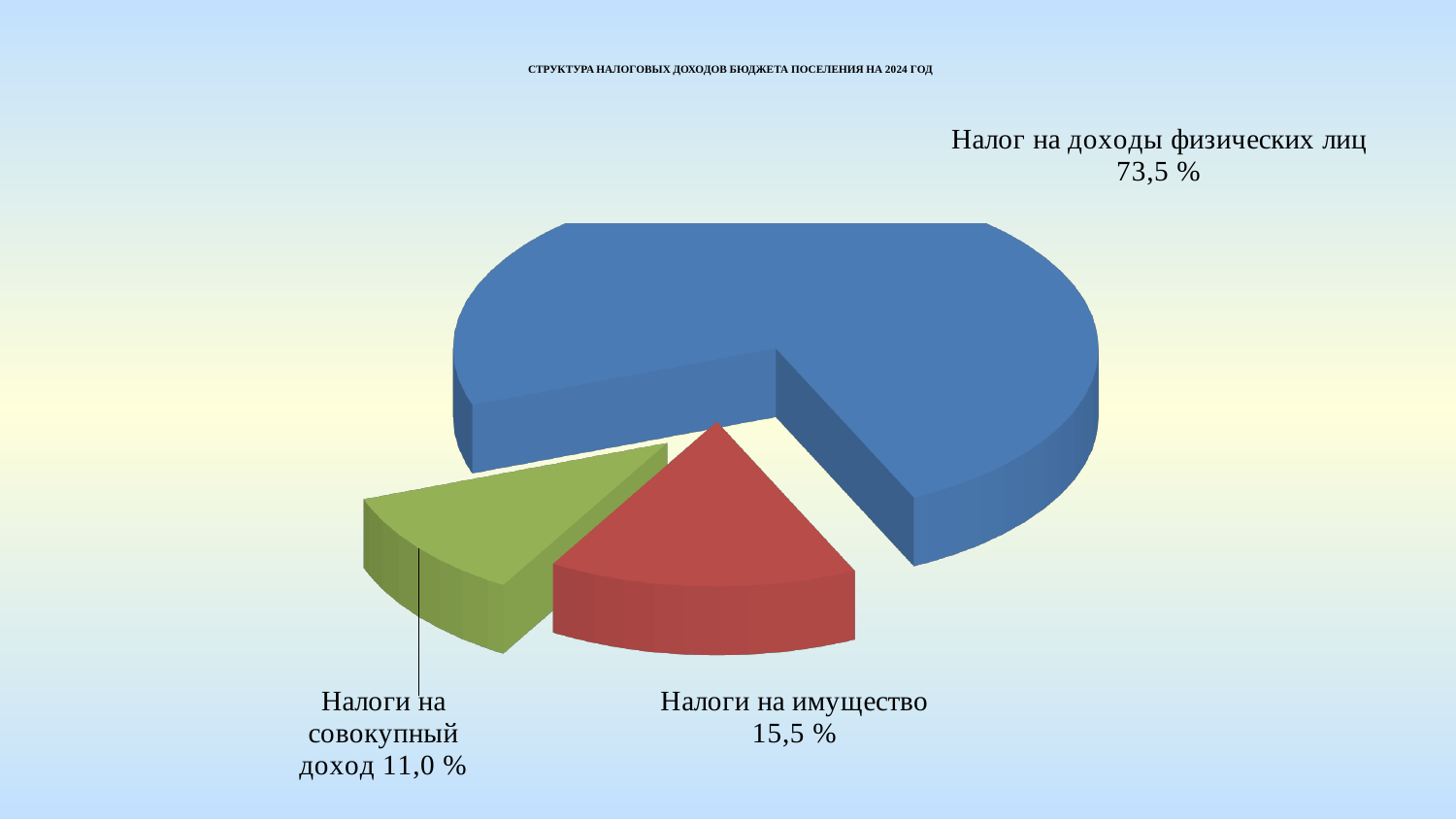
Which category has the smallest share of the pie? Налоги на совокупный доход What is the value shown for "Налоги на совокупный доход"? 11,0 % What type of chart is shown on the slide? Pie chart What is the difference between the shares of "Налог на доходы физических лиц" and "Налоги на имущество"? 58,0 % What is the value shown for "Налоги на имущество"? 15,5 % How many slices does the pie chart have? 3 Which is larger: the share of "Налоги на имущество" or "Налоги на совокупный доход"? Налоги на имущество What colour is the slice for "Налоги на имущество"? Red What share of the pie does "Налог на доходы физических лиц" have? 73,5 % What is the difference between the shares of "Налоги на имущество" and "Налоги на совокупный доход"? 4,5 % What is the title of the chart? СТРУКТУРА НАЛОГОВЫХ ДОХОДОВ БЮДЖЕТА ПОСЕЛЕНИЯ НА 2024 ГОД Which category has the largest share of the pie? Налог на доходы физических лиц